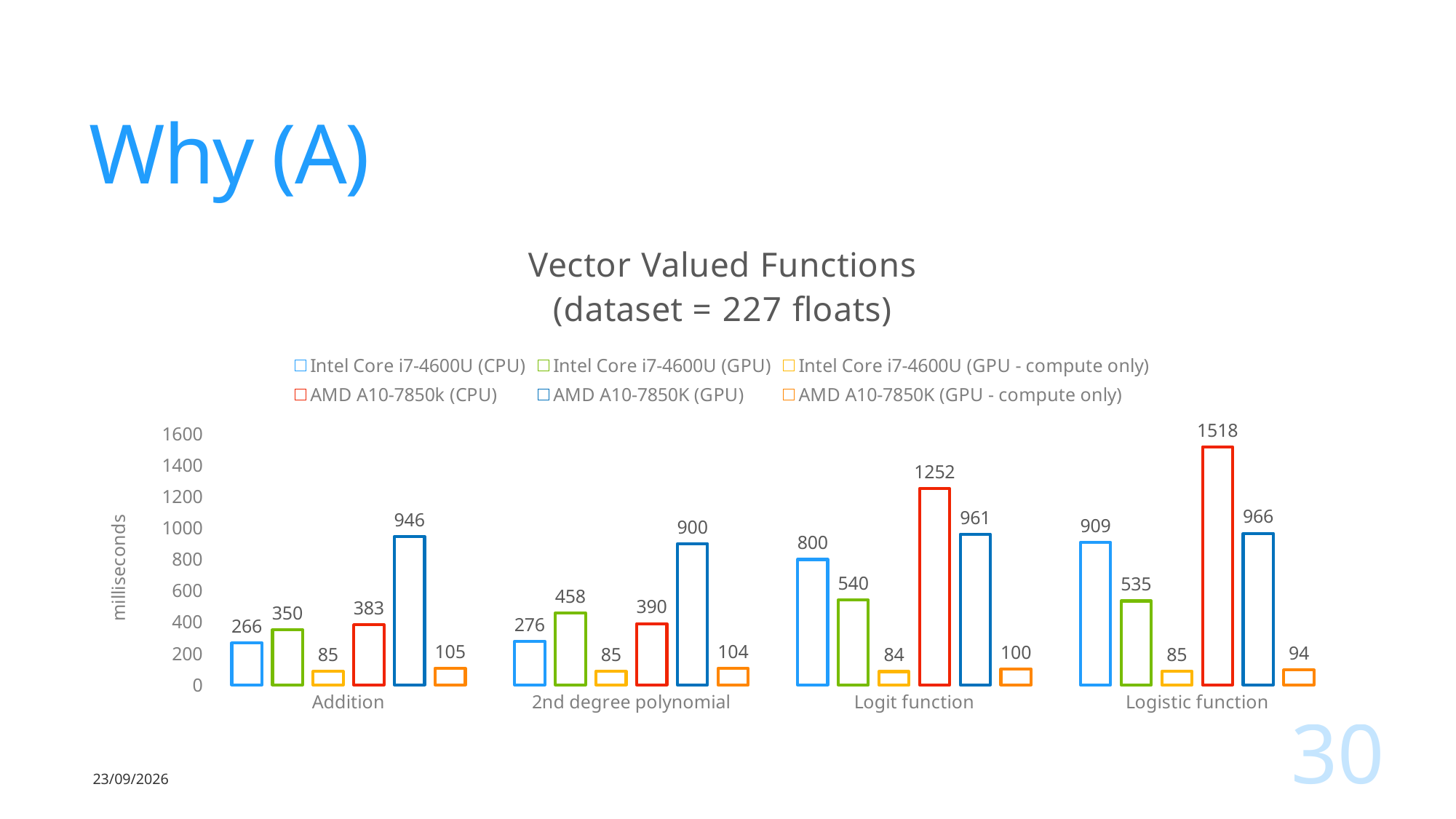
What is the value for AMD A10-7850k (CPU) in the Logistic function category? 1518 What is the value for AMD A10-7850K (GPU) in the 2nd degree polynomial category? 900 In the Addition category, which is larger: the AMD A10-7850K (GPU) value or the Intel Core i7-4600U (GPU) value? AMD A10-7850K (GPU) What kind of chart is shown on the slide? Bar chart What is the label of the vertical axis? milliseconds What is the value for Intel Core i7-4600U (GPU) in the Logit function category? 540 What is the difference between the AMD A10-7850k (CPU) value and the Intel Core i7-4600U (CPU) value in the Logit function category? 452 What is the value for Intel Core i7-4600U (CPU) in the Addition category? 266 Which category has the highest value for AMD A10-7850k (CPU)? Logistic function How many categories are shown on the x axis? 4 How many series does the legend list? 6 Which category has the lowest value for Intel Core i7-4600U (CPU)? Addition